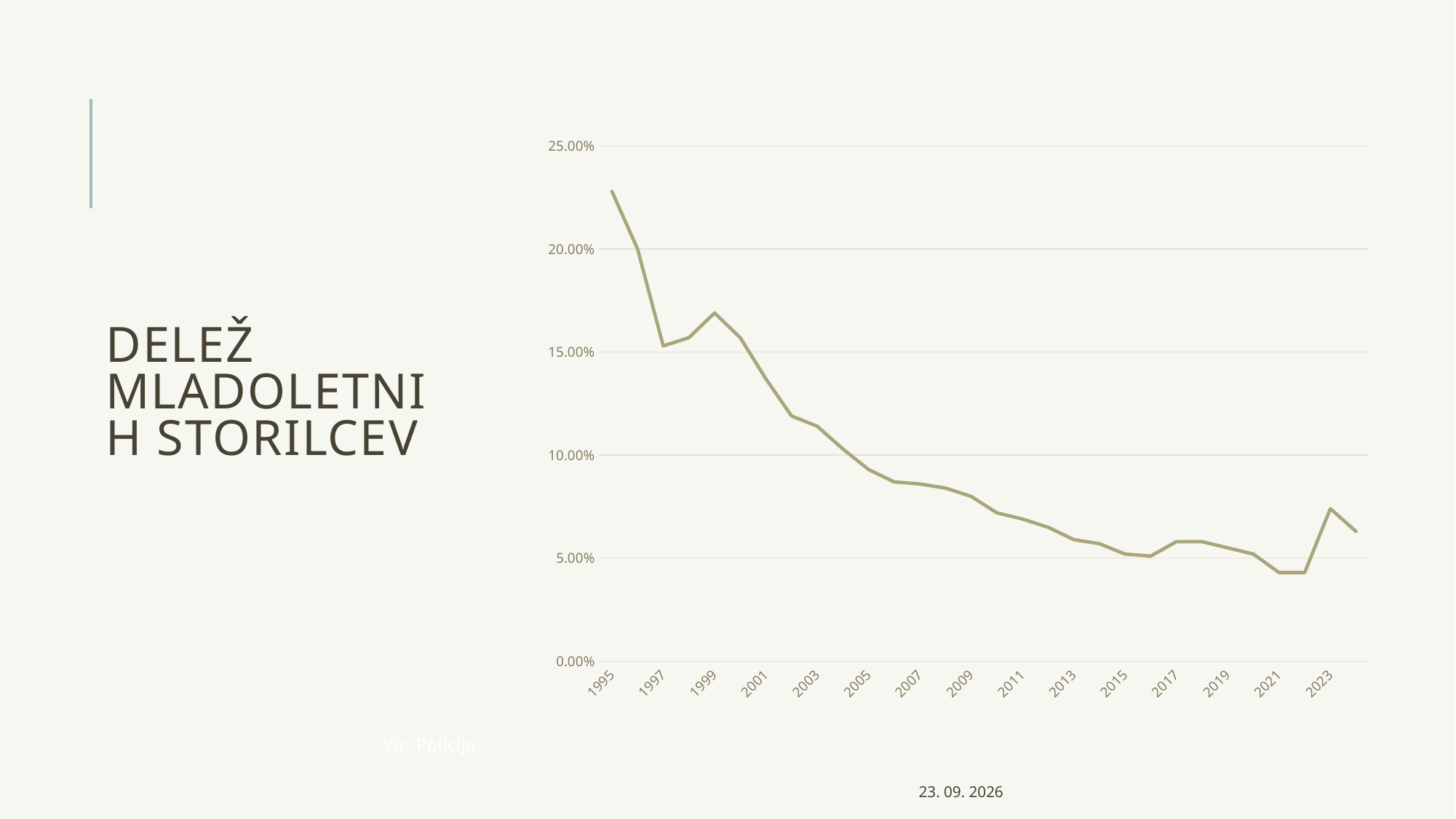
Is the value for 2003 greater or less than 10.00%? greater Which year has the highest value on the chart? 1995 What source is cited for the chart data? Vir: Policija Is the value for 2005 greater or less than 10.00%? less Which year has the larger value, 2021 or 2023? 2023 Is the value for 2021 greater or less than 5.00%? less What kind of chart is shown on the slide? line chart Which year has the larger value, 1997 or 1999? 1999 What is the title of the slide containing the chart? DELEŽ MLADOLETNIH STORILCEV Overall, do the values rise or fall from 1995 to 2023? fall